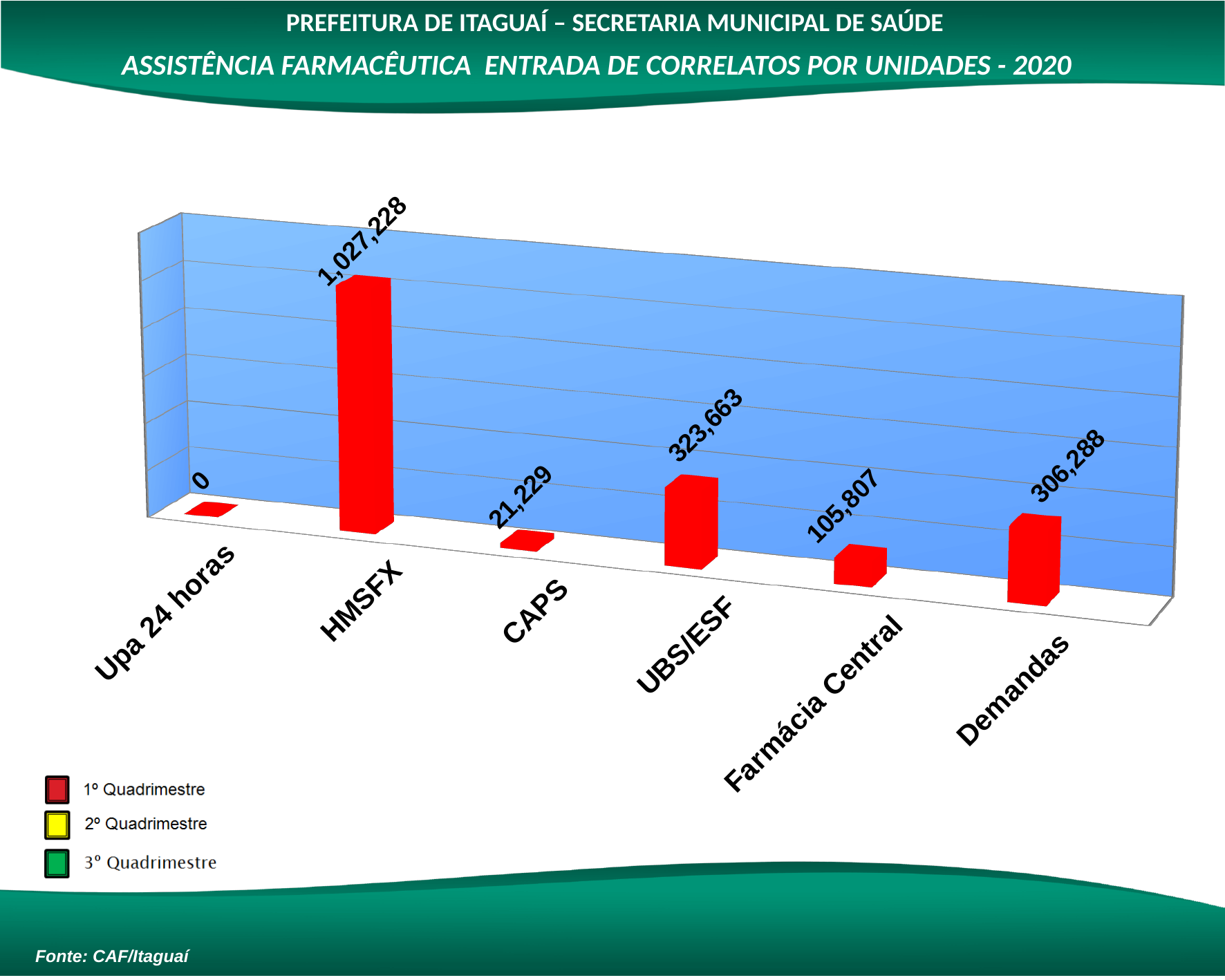
What is the value for CAPS? 21,229 How many categories are shown on the x axis? 6 What is the difference between the values for UBS/ESF and Demandas? 17,375 Which is larger, the value for Farmácia Central or the value for CAPS? Farmácia Central Which category has the highest value? HMSFX What is the value for Farmácia Central? 105,807 What kind of chart is shown on the slide? Bar chart What is the value for UBS/ESF? 323,663 Which category has the lowest value? Upa 24 horas What is the value for HMSFX? 1,027,228 What is the value for Demandas? 306,288 How many series does the legend list? 3